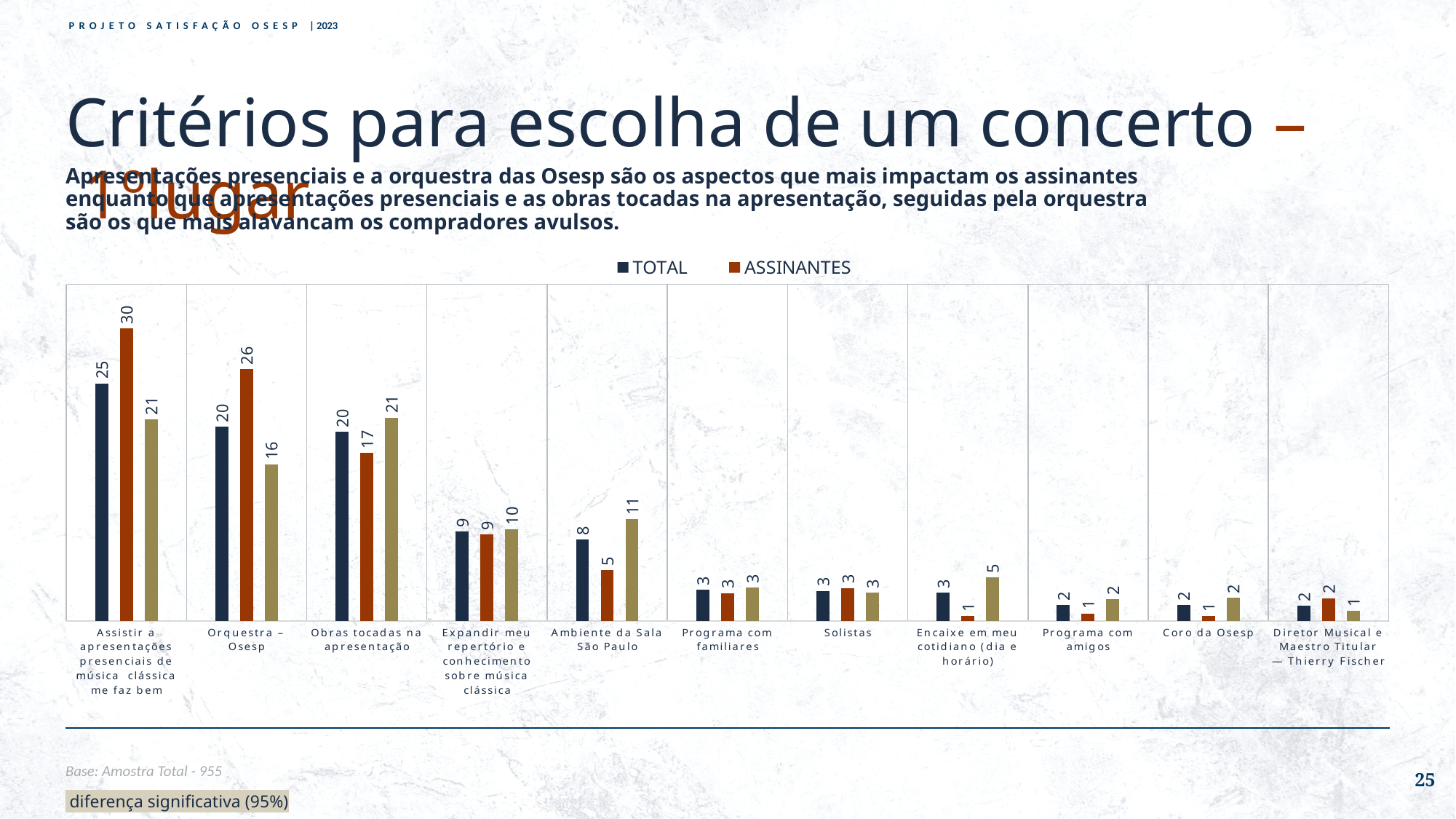
How many series does the chart legend list? 2 For "Assistir a apresentações presenciais de música clássica me faz bem", which is larger: the TOTAL value or the ASSINANTES value? ASSINANTES What is the TOTAL value for "Orquestra – Osesp"? 20 What kind of chart is shown on the slide? Bar chart For "Ambiente da Sala São Paulo", which is larger: the TOTAL value or the ASSINANTES value? TOTAL How many categories are shown on the x axis of the chart? 11 Which category has the highest ASSINANTES value? Assistir a apresentações presenciais de música clássica me faz bem What is the TOTAL value for "Encaixe em meu cotidiano (dia e horário)"? 3 What is the difference between the TOTAL and ASSINANTES values for "Obras tocadas na apresentação"? 3 What is the ASSINANTES value for "Assistir a apresentações presenciais de música clássica me faz bem"? 30 What is the difference between the ASSINANTES and TOTAL values for "Orquestra – Osesp"? 6 What is the ASSINANTES value for "Ambiente da Sala São Paulo"? 5